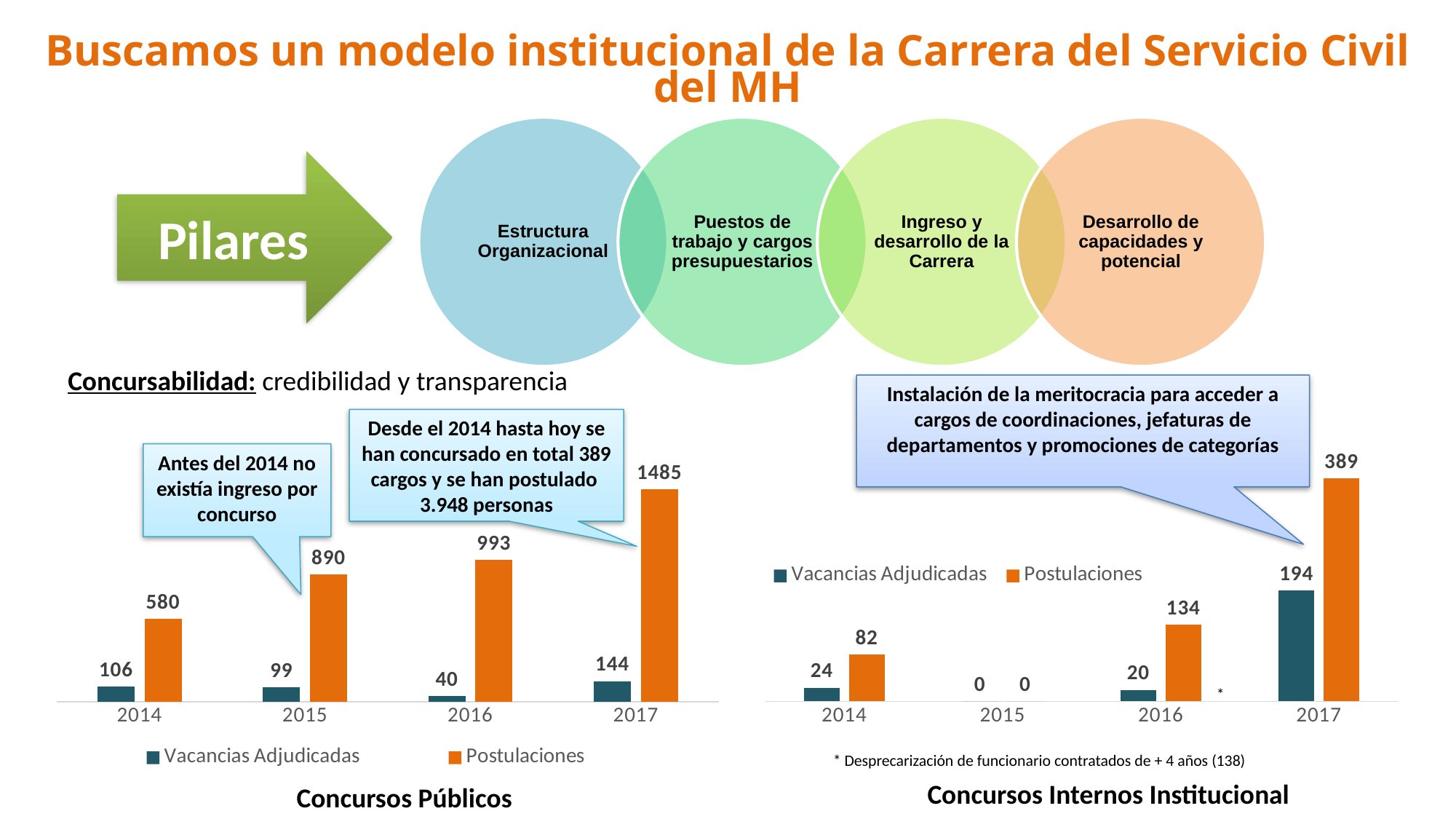
In the Concursos Internos Institucional chart, what is the difference between Postulaciones and Vacancias Adjudicadas in 2017? 195 What type of chart is the Concursos Internos Institucional chart? bar chart In the Concursos Internos Institucional chart, what is the value of Vacancias Adjudicadas for 2017? 194 In the Concursos Internos Institucional chart, which year has the highest value for Postulaciones? 2017 In the Concursos Internos Institucional chart, which is larger: Vacancias Adjudicadas in 2014 or in 2016? 2014 In the Concursos Internos Institucional chart, what is the value of Postulaciones for 2016? 134 In the Concursos Públicos chart, what is the difference between Postulaciones in 2017 and 2016? 492 In the Concursos Públicos chart, what is the value of Postulaciones for 2017? 1485 In the Concursos Públicos chart, what is the value of Vacancias Adjudicadas for 2016? 40 In the Concursos Públicos chart, which year has the lowest value for Vacancias Adjudicadas? 2016 How many series does the legend of the Concursos Públicos chart list? 2 In the Concursos Públicos chart, do the Postulaciones values rise or fall from 2014 to 2017? rise